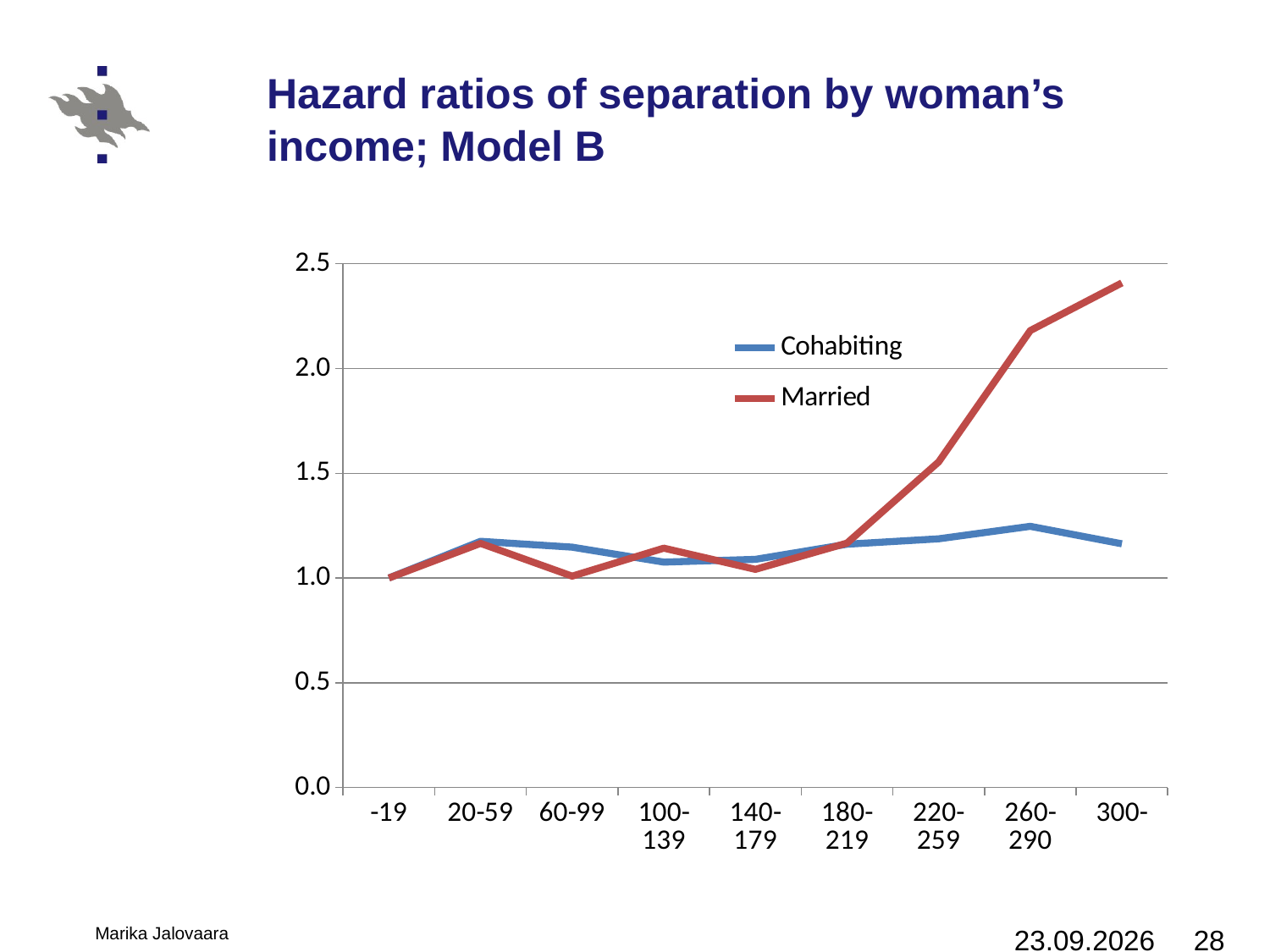
Which series has the larger value at the 260-290 income category, Cohabiting or Married? Married How many income categories are shown on the x axis? 9 For which income category is the Married hazard ratio highest? 300- Does the Married line rise or fall from the 180-219 category to the 300- category? rise What is the hazard ratio for the -19 income category, where both lines start? 1.0 Which series does the red line represent? Married How many series does the legend list? 2 Is the Cohabiting value for the 300- income category greater or less than 1.5? less Which series has the larger value at the 300- income category, Cohabiting or Married? Married Is the Married value for the 300- income category greater or less than 2.0? greater What kind of chart is shown on the slide? line chart